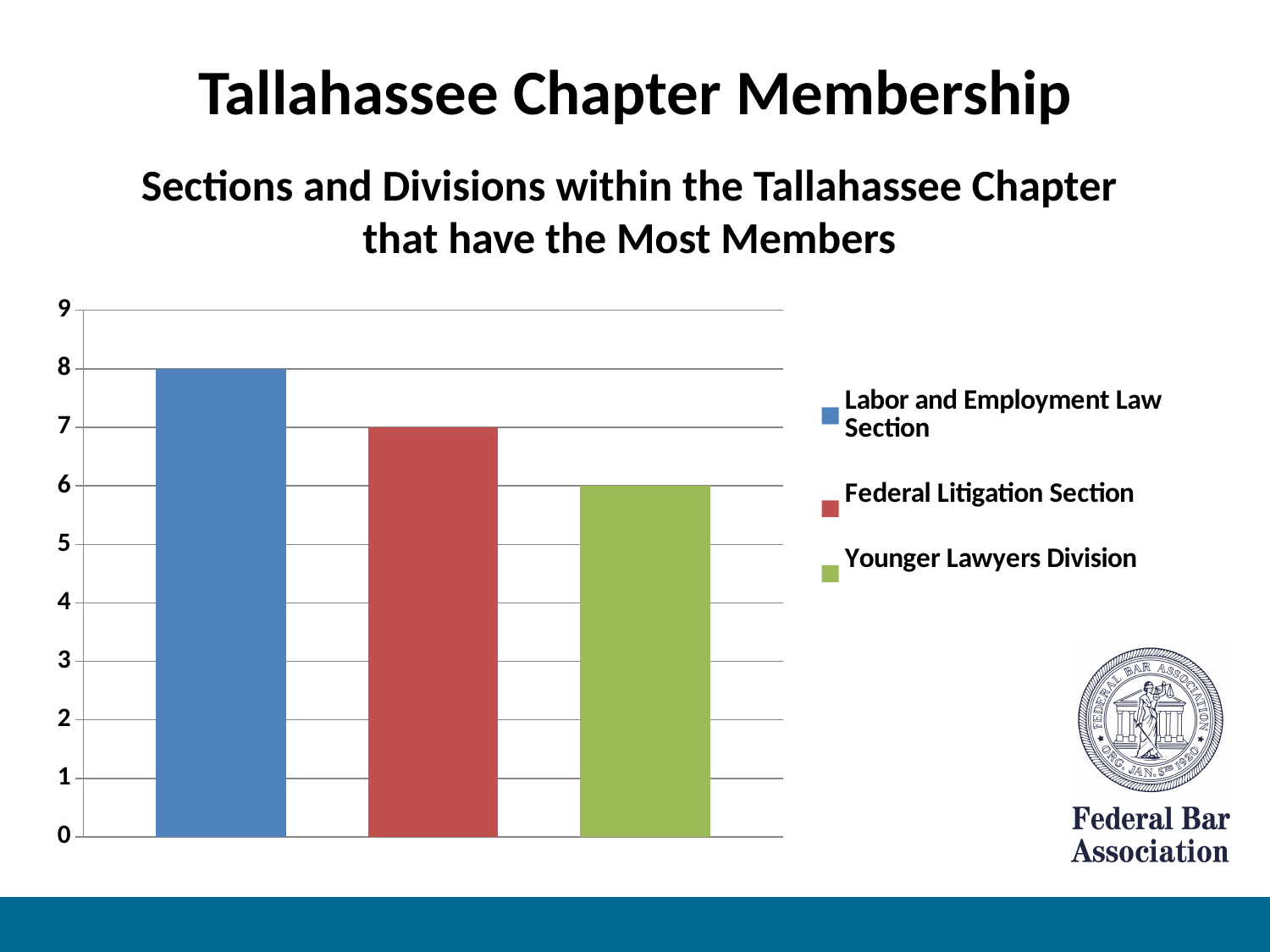
What kind of chart is shown on the slide? Bar chart What is the difference between the Labor and Employment Law Section and the Younger Lawyers Division? 2 How many entries does the legend list? 3 Which section or division has the highest value? Labor and Employment Law Section How many bars are plotted in the chart? 3 Which section or division has the lowest value? Younger Lawyers Division What is the value for the Federal Litigation Section? 7 Which is larger, the Federal Litigation Section or the Younger Lawyers Division? Federal Litigation Section What is the value for the Labor and Employment Law Section? 8 What is the difference between the Federal Litigation Section and the Younger Lawyers Division? 1 What colour is the bar for the Federal Litigation Section? Red What is the value for the Younger Lawyers Division? 6